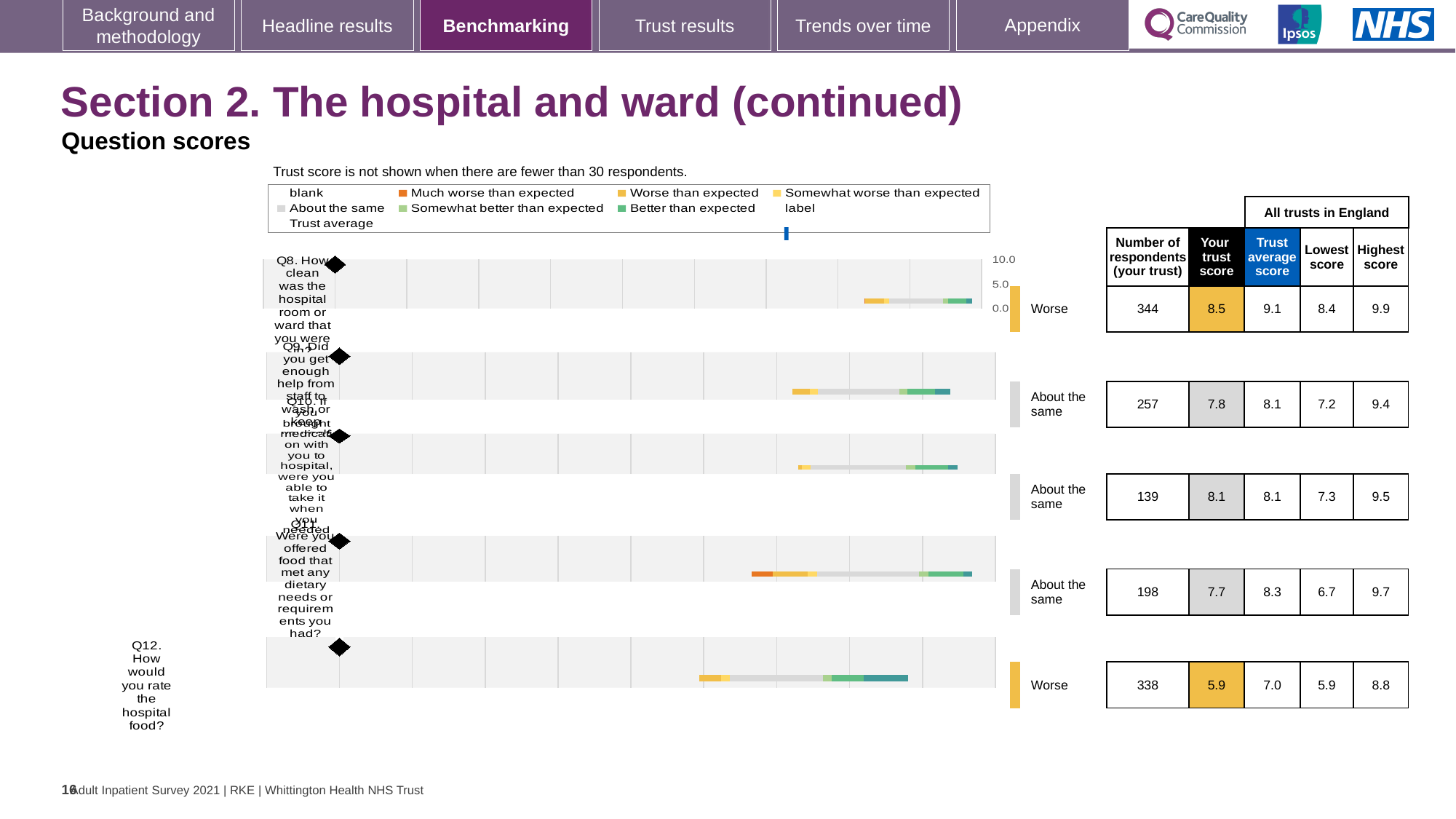
What is the highest score across all trusts in England for Q8? 9.9 What is the trust score for Q12 (How would you rate the hospital food?)? 5.9 What is the lowest score across all trusts in England for Q11? 6.7 What kind of chart is used to show the question scores? bar chart What is the difference between the trust average score and your trust score for Q12? 1.1 How many of the questions on this slide are rated 'Worse' for this trust? 2 For Q8, is your trust score higher or lower than the trust average score? lower Which question has the highest number of respondents at this trust? Q8 (How clean was the hospital room or ward) How many questions are shown on this slide? 5 How many respondents answered Q8 (How clean was the hospital room or ward) at this trust? 344 Which question has the lowest 'Your trust score' on this slide? Q12 (How would you rate the hospital food?) What is the trust average score for Q11 (Were you offered food that met any dietary needs or requirements you had?)? 8.3